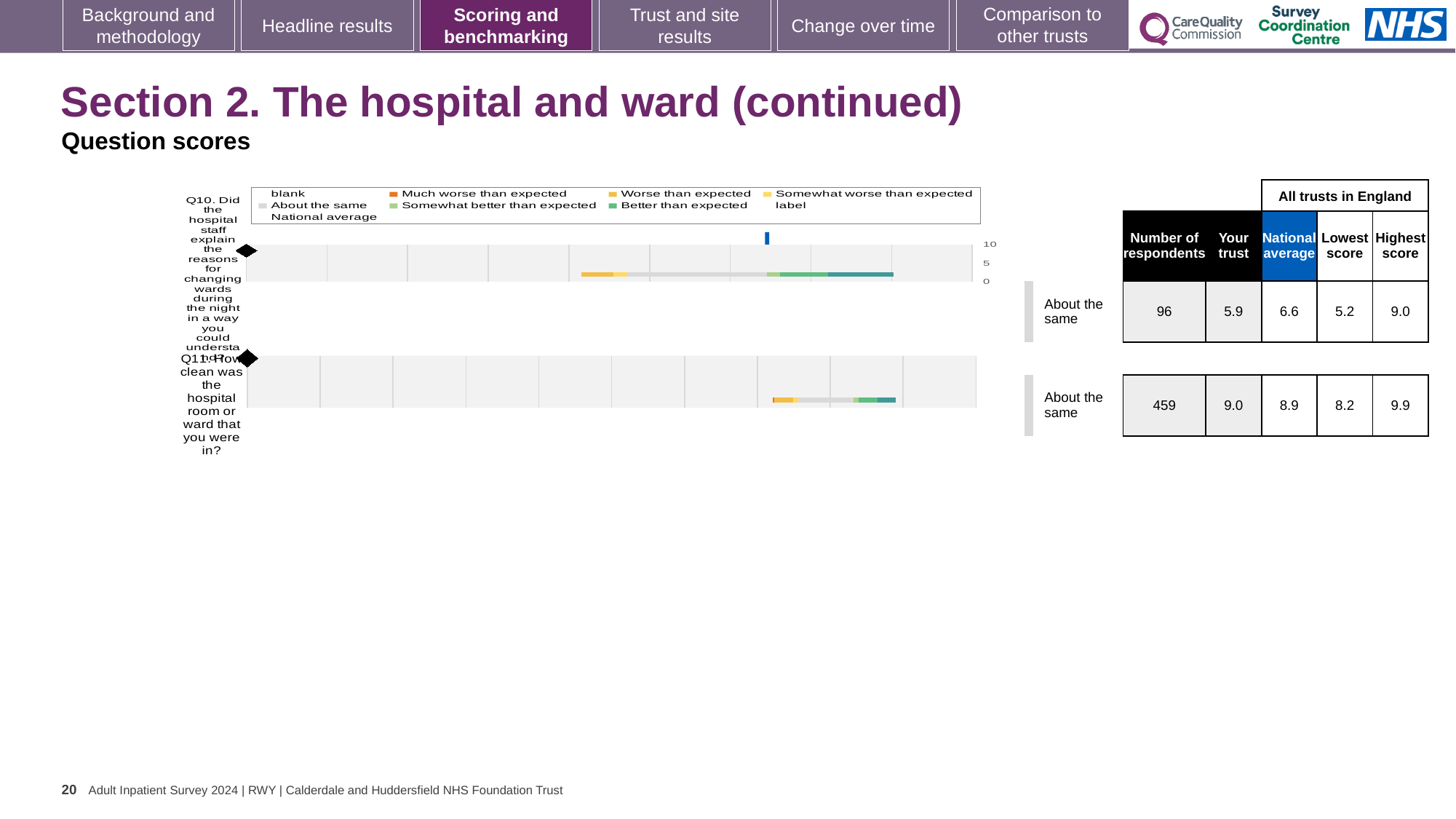
How many respondents answered Q11 (how clean was the hospital room or ward)? 459 How many survey questions are plotted on the slide? 2 For Q10, what is the difference between the highest score and the lowest score across all trusts in England? 3.8 For Q11, what is the difference between the highest score and the lowest score across all trusts in England? 1.7 For Q10, which is larger: the 'Your trust' score or the national average? National average What is the national average score for Q10 (explaining reasons for changing wards during the night)? 6.6 What kind of chart is used to show the Q10 and Q11 question scores? bar chart What is the 'Your trust' score for Q11 (how clean was the hospital room or ward)? 9.0 What benchmark category is shown for Q11 (how clean was the hospital room or ward)? About the same Which question has the higher 'Your trust' score, Q10 or Q11? Q11 What benchmark category is shown for Q10 (explaining reasons for changing wards during the night)? About the same What is the highest value shown on the score axis of the Q10 chart? 10